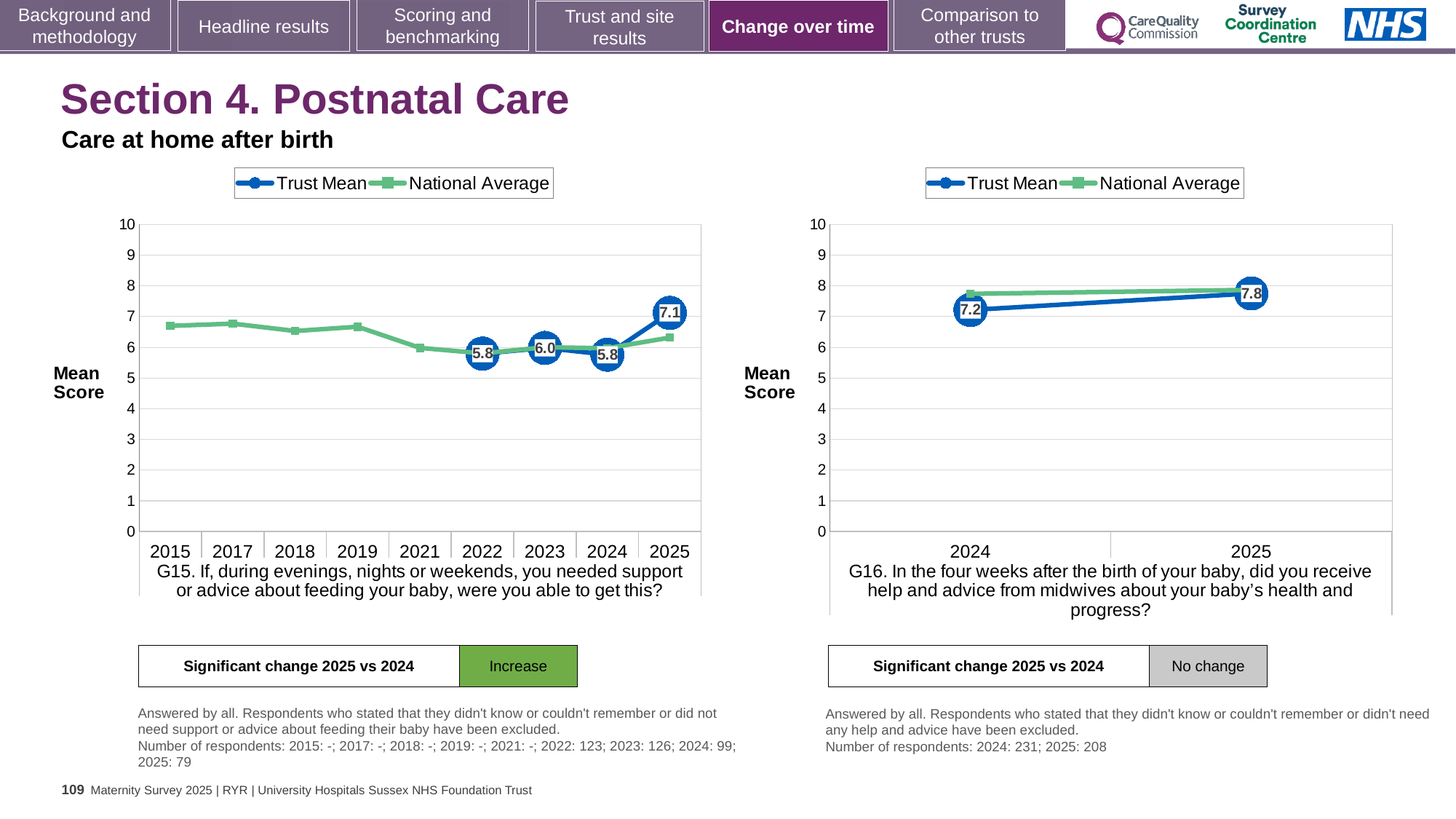
In the left chart (G15), what is the Trust Mean for 2025? 7.1 In the right chart (G16), what is the difference between the Trust Mean in 2025 and 2024? 0.6 In the right chart (G16), what is the Trust Mean for 2024? 7.2 In the left chart (G15), by how much did the Trust Mean change from 2024 to 2025? 1.3 In the left chart (G15), is the Trust Mean for 2025 larger or smaller than the Trust Mean for 2023? larger How many years are shown on the x axis of the left chart (G15)? 9 In the right chart (G16), what is the Trust Mean for 2025? 7.8 What type of chart is the right chart (G16)? Line chart In the left chart (G15), is the National Average for 2015 greater or less than 6? greater How many series does the legend of the right chart (G16) list? 2 In the left chart (G15), what is the Trust Mean for 2023? 6.0 In the left chart (G15), which year has the highest Trust Mean? 2025